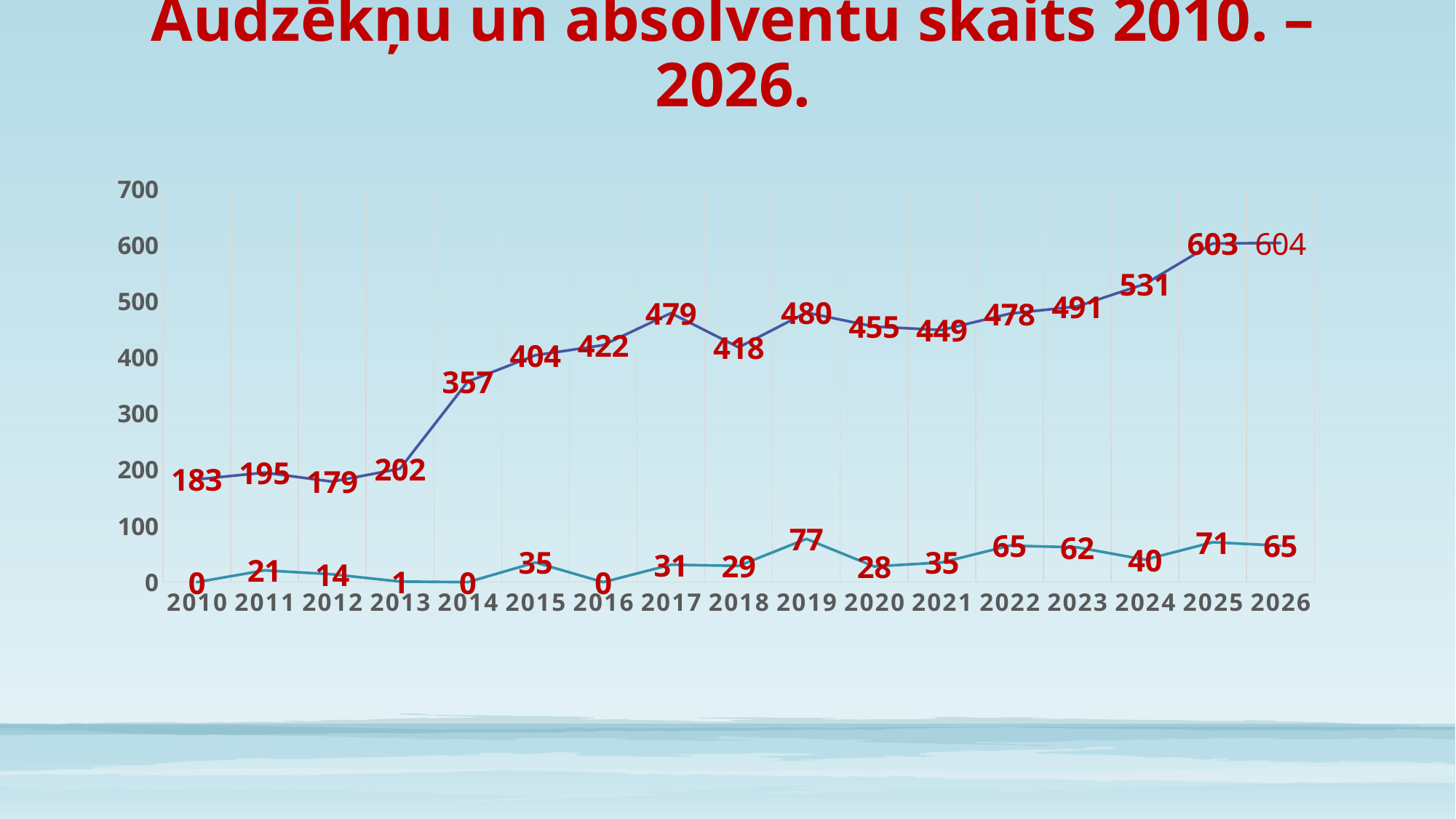
Does the upper line generally rise or fall from 2010 to 2026? rise What is the difference between the upper line values for 2025 and 2024? 72 In which year does the upper line have its lowest value? 2012 What is the value of the upper line for 2014? 357 What is the value of the upper line for 2026? 604 What is the title of the chart on the slide? Audzēkņu un absolventu skaits 2010. – 2026. In which year does the lower line reach its highest value? 2019 How many years are shown on the x axis of the chart? 17 In which year does the upper line reach its highest value? 2026 Which is larger on the upper line: the value for 2017 or the value for 2018? 2017 What kind of chart is shown on the slide? line chart What is the value of the lower line for 2019? 77